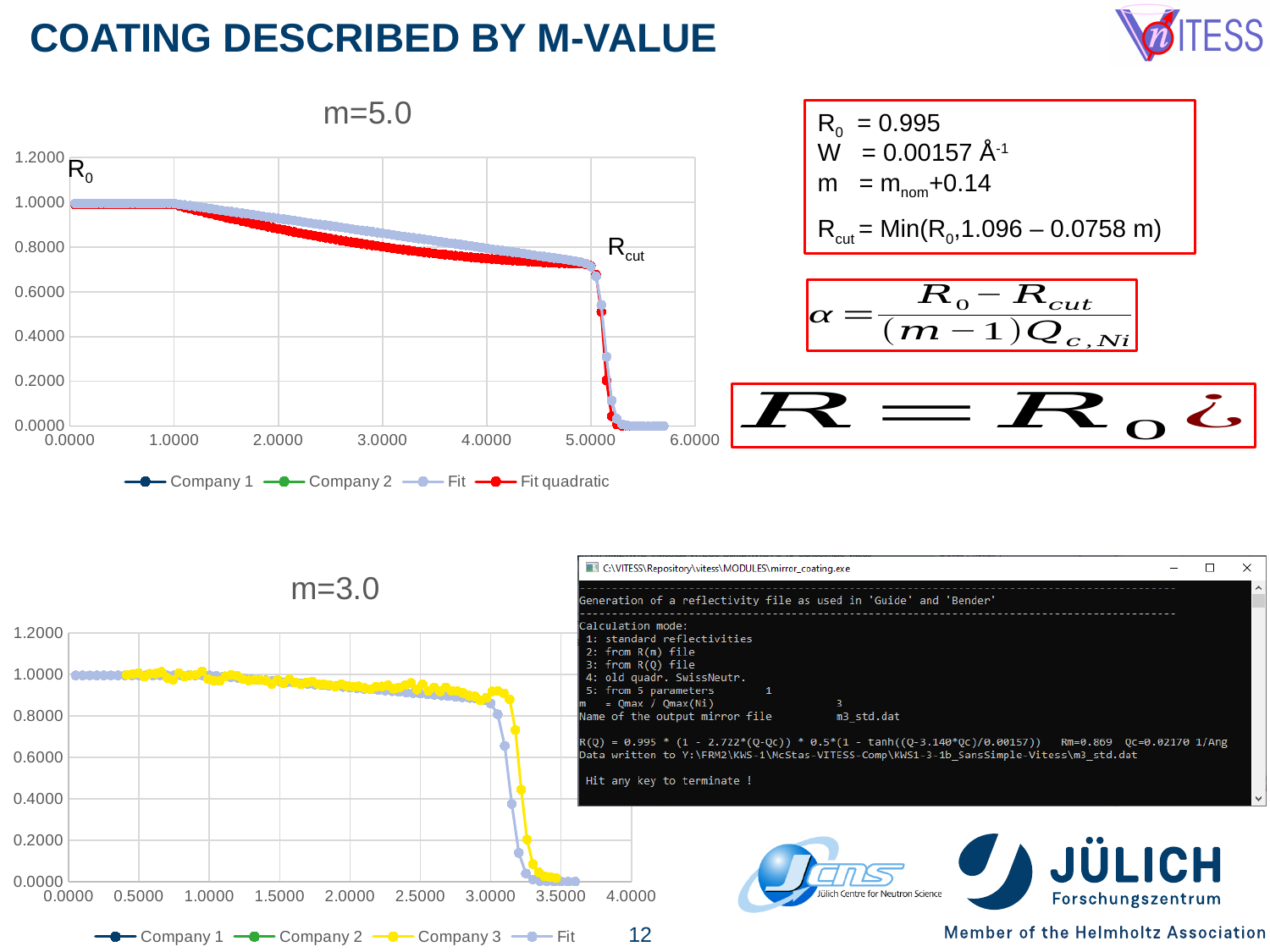
In the top chart (m=5.0), is the Fit value at x = 5.5000 greater or less than 0.2000? less In the bottom chart (m=3.0), do the Company 3 values rise or fall as the x value increases? fall How many series does the legend of the bottom chart (m=3.0) list? 4 In the top chart (m=5.0), do the Fit values rise or fall as the x value increases? fall In the bottom chart (m=3.0), what colour is the Company 3 series? yellow What is the title of the top chart on the slide? m=5.0 In the bottom chart (m=3.0), is the Fit value at x = 3.5000 greater or less than 0.2000? less What kind of chart is the bottom chart titled m=3.0? line chart How many series does the legend of the top chart (m=5.0) list? 4 In the top chart (m=5.0), is the Fit value at x = 2.0000 greater or less than 0.8000? greater What kind of chart is the top chart titled m=5.0? line chart